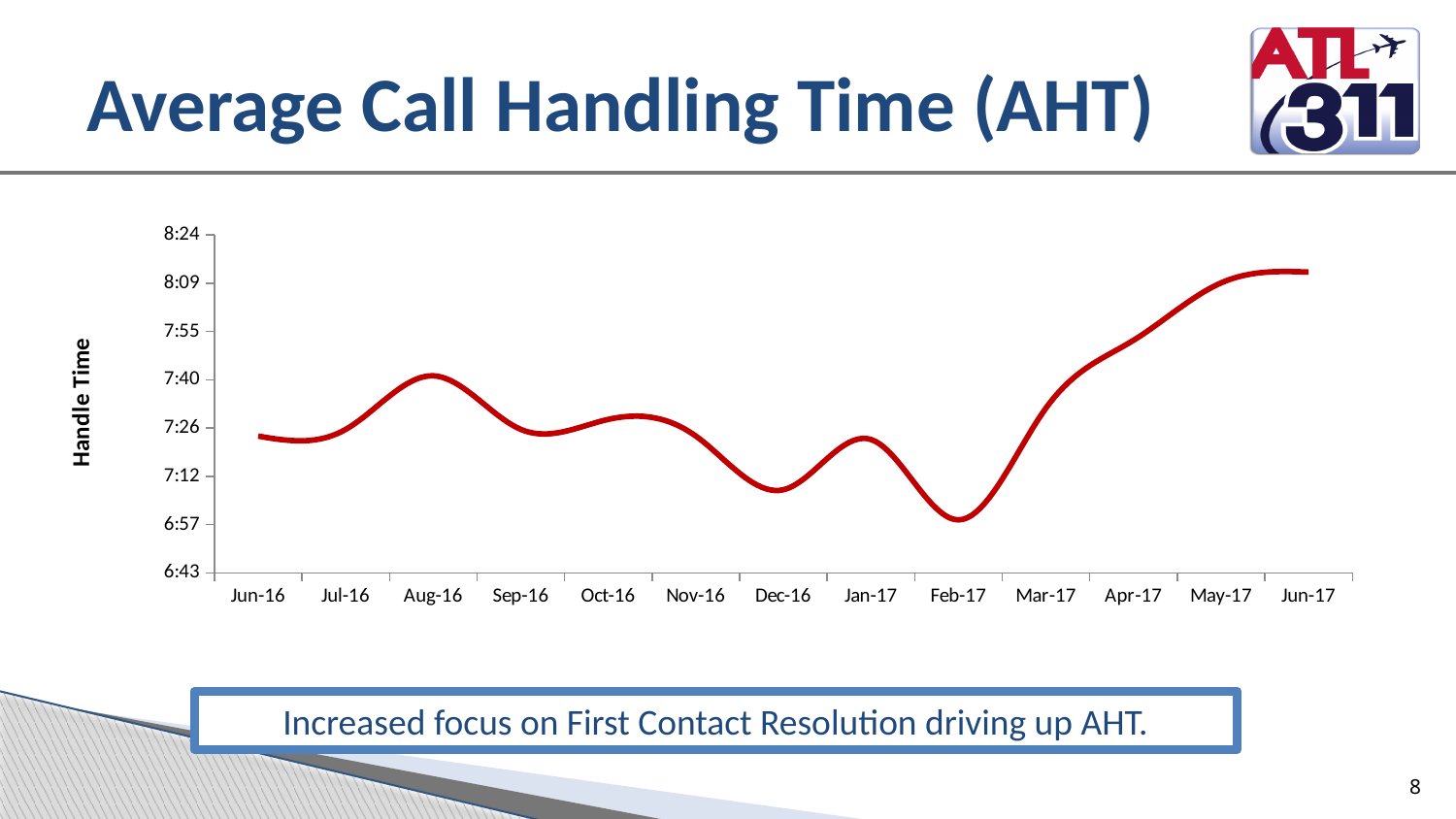
How many months are plotted along the x axis? 13 Is the value for Aug-16 greater or less than 7:26? greater Which month has the lowest average call handling time? Feb-17 What is the label on the vertical axis? Handle Time Which is larger, the value for Jun-16 or the value for Jun-17? Jun-17 Is the value for Feb-17 greater or less than 7:12? less What kind of chart is shown on the slide? Line chart Is the value for Apr-17 greater or less than 7:40? greater Which month has the highest average call handling time? Jun-17 Does the handle time rise or fall between Feb-17 and Jun-17? rise